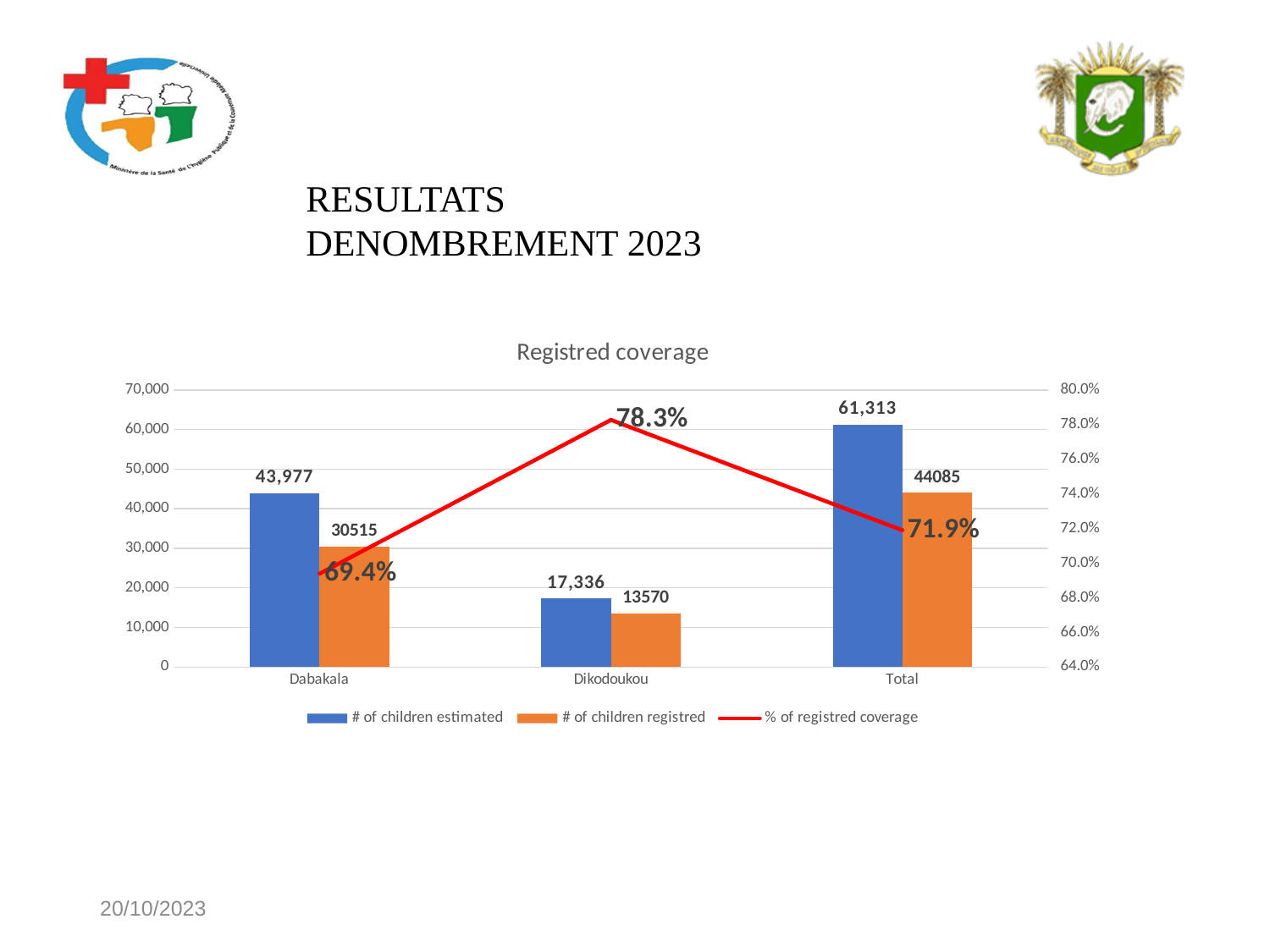
What is the % of registred coverage for Total? 71.9% How many categories are shown on the x axis of the chart? 3 Which is larger: the number of children registred for Total or the number of children estimated for Dabakala? # of children registred for Total What is the title of the chart? Registred coverage Which category has the lowest number of children estimated? Dikodoukou Is the % of registred coverage for Dabakala greater or less than 70.0%? less How many series does the chart legend list? 3 What is the difference between the number of children estimated and the number of children registred for Dabakala? 13,462 What colour is the line for % of registred coverage? Red What is the number of children registred for Dikodoukou? 13570 Which category has the highest % of registred coverage? Dikodoukou What is the number of children estimated for Dabakala? 43,977